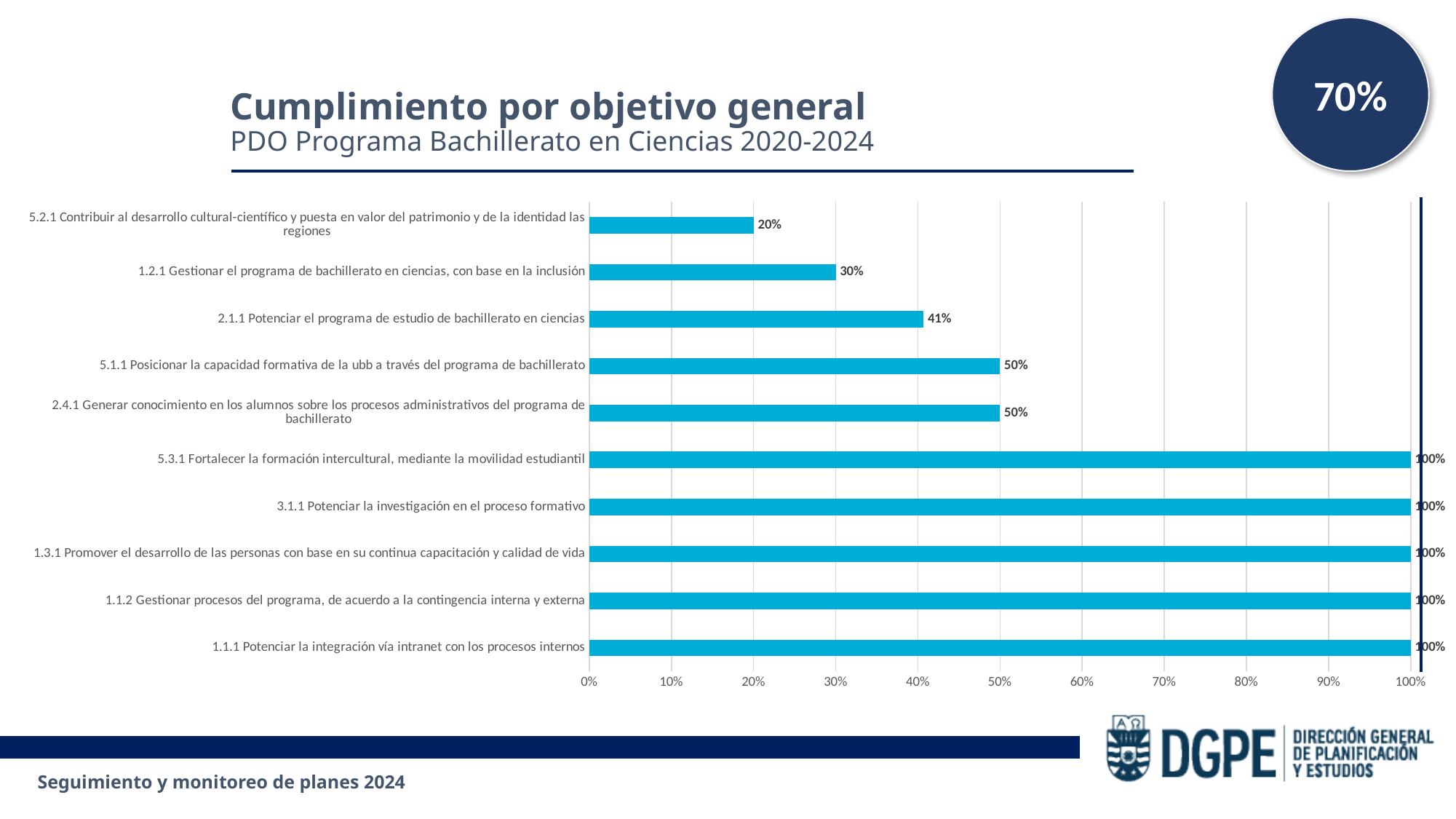
What is the value for 5.2.1 Contribuir al desarrollo cultural-científico y puesta en valor del patrimonio y de la identidad las regiones? 20% How many categories have a value of 100%? 5 What is the value for 2.1.1 Potenciar el programa de estudio de bachillerato en ciencias? 41% Which category has the lowest value? 5.2.1 Contribuir al desarrollo cultural-científico y puesta en valor del patrimonio y de la identidad las regiones Which is larger: the value for 2.1.1 Potenciar el programa de estudio de bachillerato en ciencias or the value for 1.2.1 Gestionar el programa de bachillerato en ciencias, con base en la inclusión? 2.1.1 Potenciar el programa de estudio de bachillerato en ciencias What is the difference between the values for 5.1.1 Posicionar la capacidad formativa de la ubb a través del programa de bachillerato and 1.2.1 Gestionar el programa de bachillerato en ciencias, con base en la inclusión? 20% What kind of chart is shown on the slide? Bar chart What is the title of the chart on the slide? Cumplimiento por objetivo general How many categories are shown in the chart? 10 What is the difference between the values for 2.1.1 Potenciar el programa de estudio de bachillerato en ciencias and 5.2.1 Contribuir al desarrollo cultural-científico y puesta en valor del patrimonio y de la identidad las regiones? 21% What is the value for 5.1.1 Posicionar la capacidad formativa de la ubb a través del programa de bachillerato? 50% What is the value for 1.2.1 Gestionar el programa de bachillerato en ciencias, con base en la inclusión? 30%